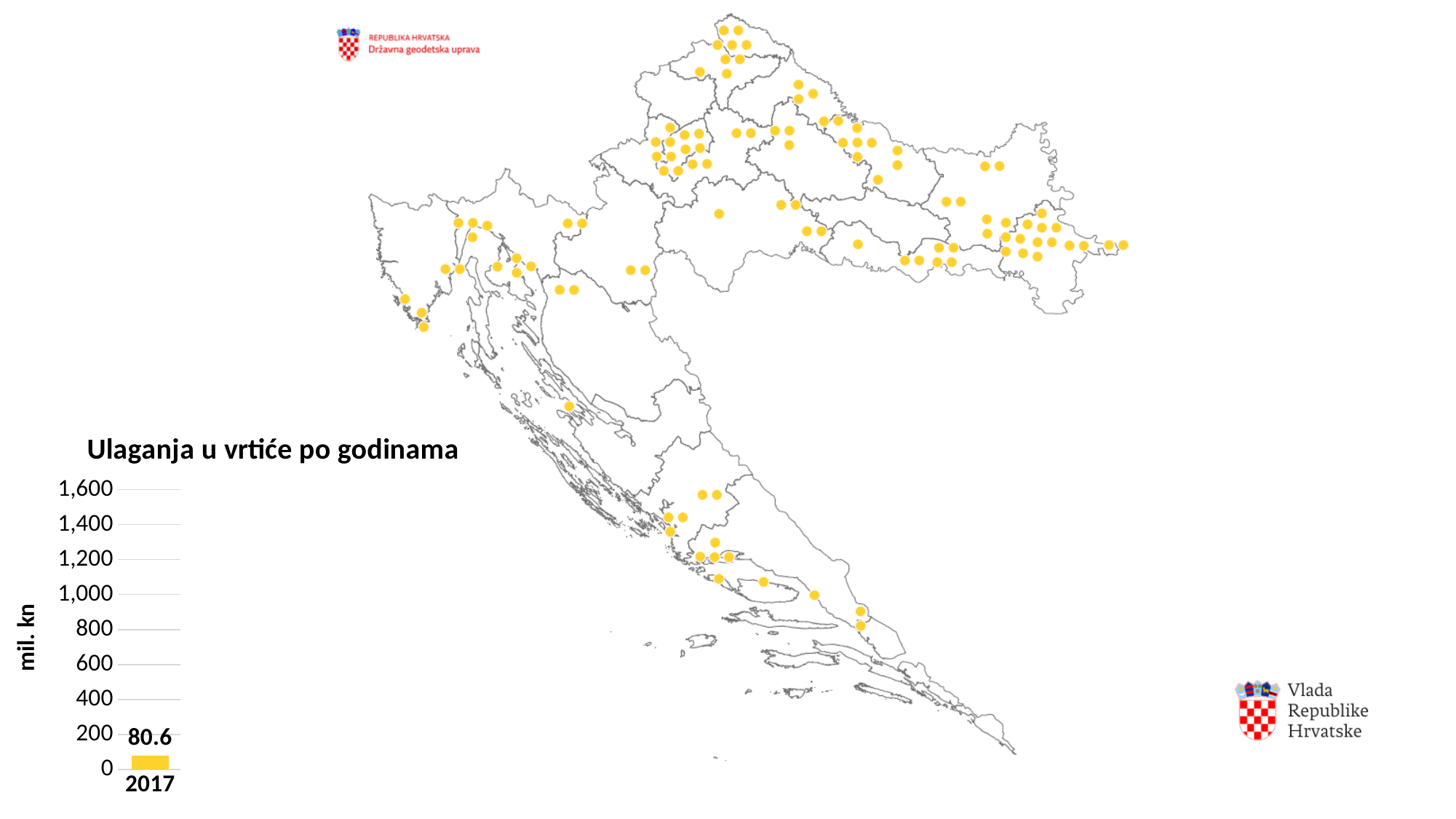
What is the y-axis label of the chart 'Ulaganja u vrtiće po godinama'? mil. kn What kind of chart is 'Ulaganja u vrtiće po godinama'? bar chart What is the highest tick value shown on the y axis of the chart 'Ulaganja u vrtiće po godinama'? 1,600 What is the value for 2017 in the chart 'Ulaganja u vrtiće po godinama'? 80.6 Which year is shown on the x axis of the chart 'Ulaganja u vrtiće po godinama'? 2017 What is the title of the bar chart on the slide? Ulaganja u vrtiće po godinama Is the value for 2017 in the chart 'Ulaganja u vrtiće po godinama' greater or less than 200? less How many categories are shown on the x axis of the chart 'Ulaganja u vrtiće po godinama'? 1